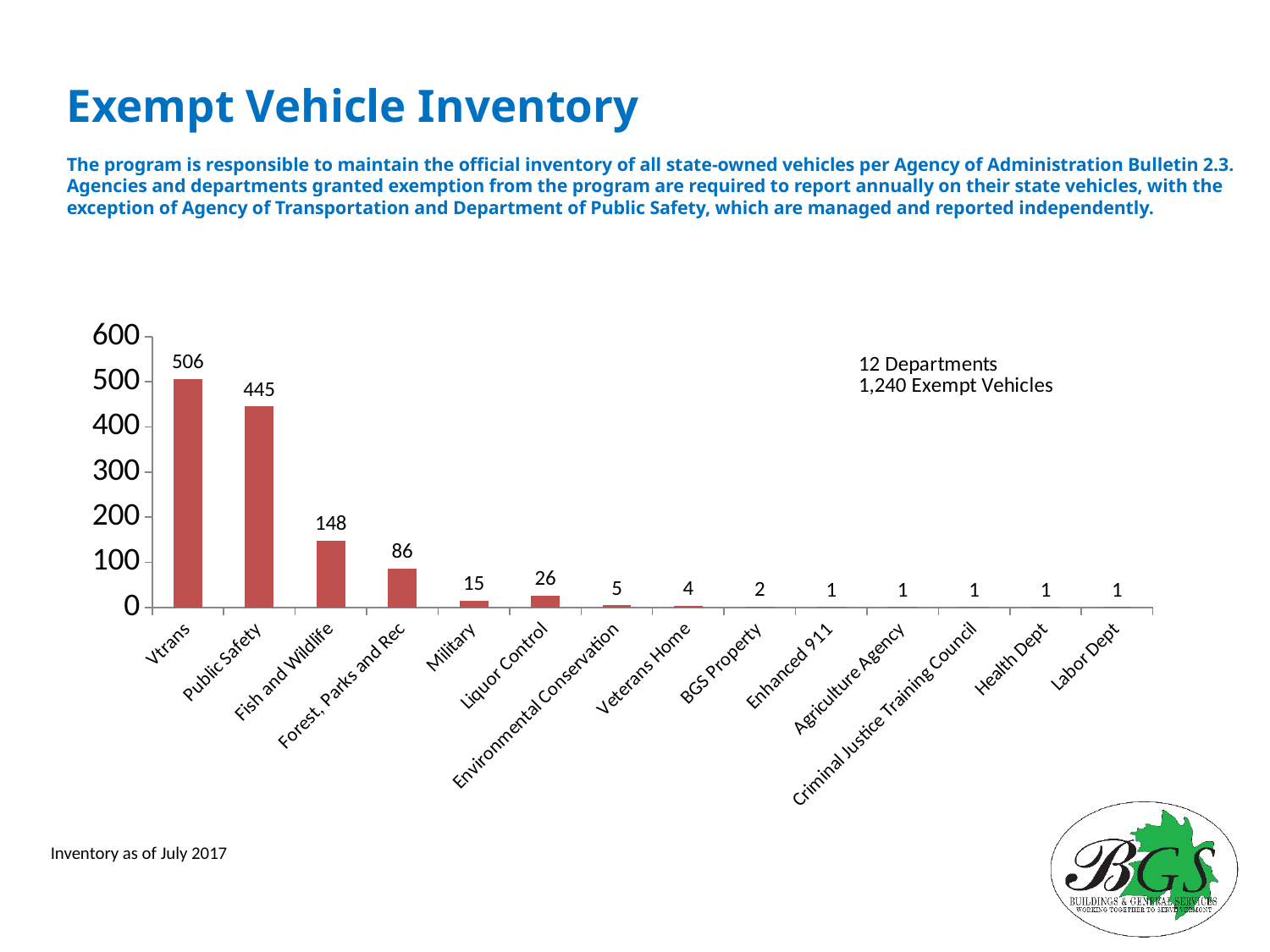
What is the value for Public Safety? 445 What is the value for Environmental Conservation? 5 How many categories are shown on the x axis? 14 What is the value for Vtrans? 506 What is the difference between the values for Vtrans and Public Safety? 61 What is the title of the slide containing the chart? Exempt Vehicle Inventory What is the value for Liquor Control? 26 Which is larger, the value for Military or the value for Liquor Control? Liquor Control Which category has the highest value? Vtrans What kind of chart is shown on the slide? Bar chart What is the difference between the values for Fish and Wildlife and Forest, Parks and Rec? 62 What is the value for Fish and Wildlife? 148